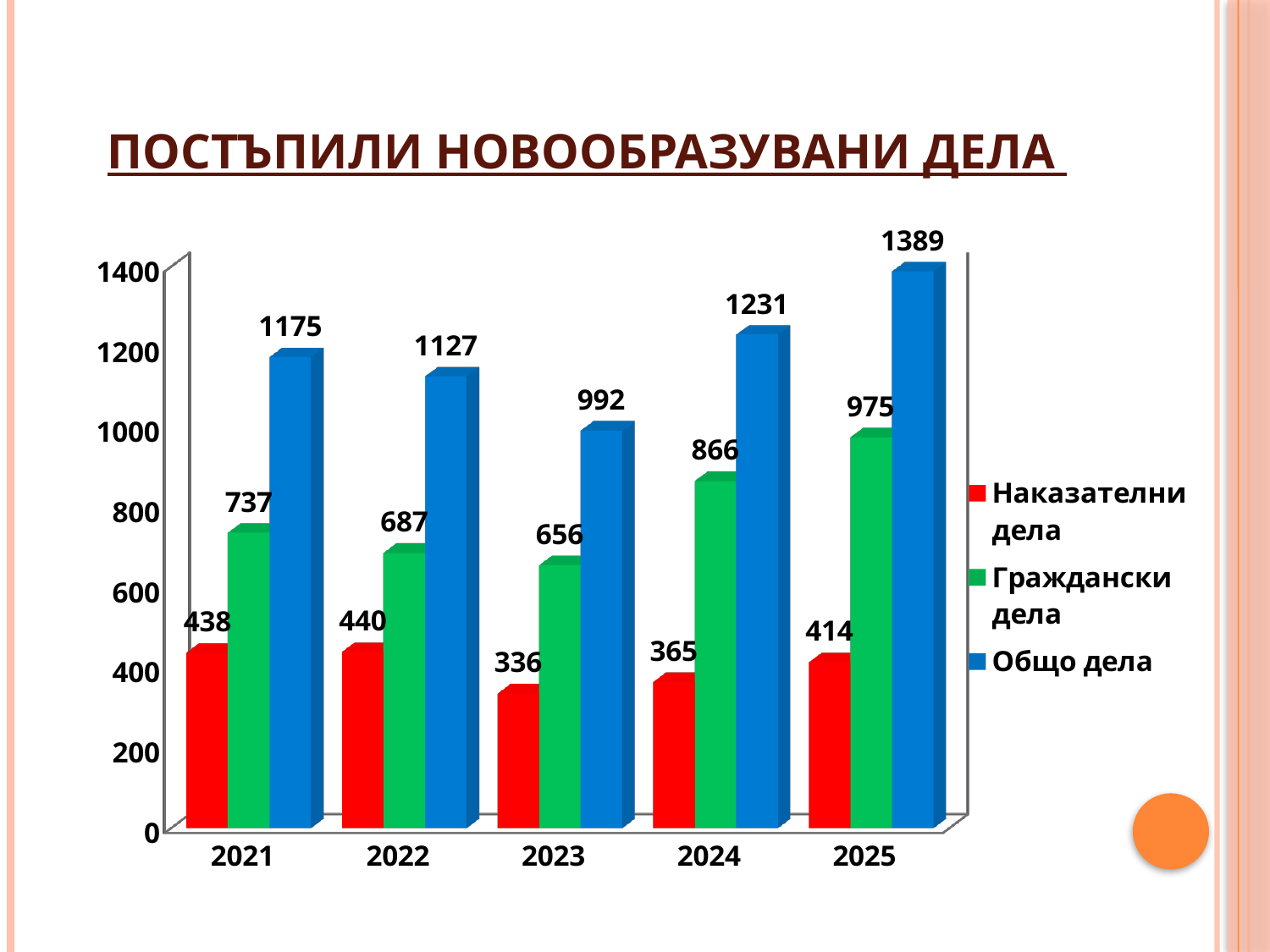
How many years are shown on the x axis? 5 Does the value of Граждански дела rise or fall from 2023 to 2025? rise What is the value of Наказателни дела for 2023? 336 How many series does the legend list? 3 Which is larger: Граждански дела in 2021 or in 2022? 2021 What is the title of the chart? ПОСТЪПИЛИ НОВООБРАЗУВАНИ ДЕЛА What is the value of Общо дела for 2025? 1389 What is the difference between Общо дела in 2025 and in 2024? 158 What kind of chart is shown on the slide? bar chart What is the value of Граждански дела for 2024? 866 Which year has the lowest value for Наказателни дела? 2023 Which year has the highest value for Общо дела? 2025